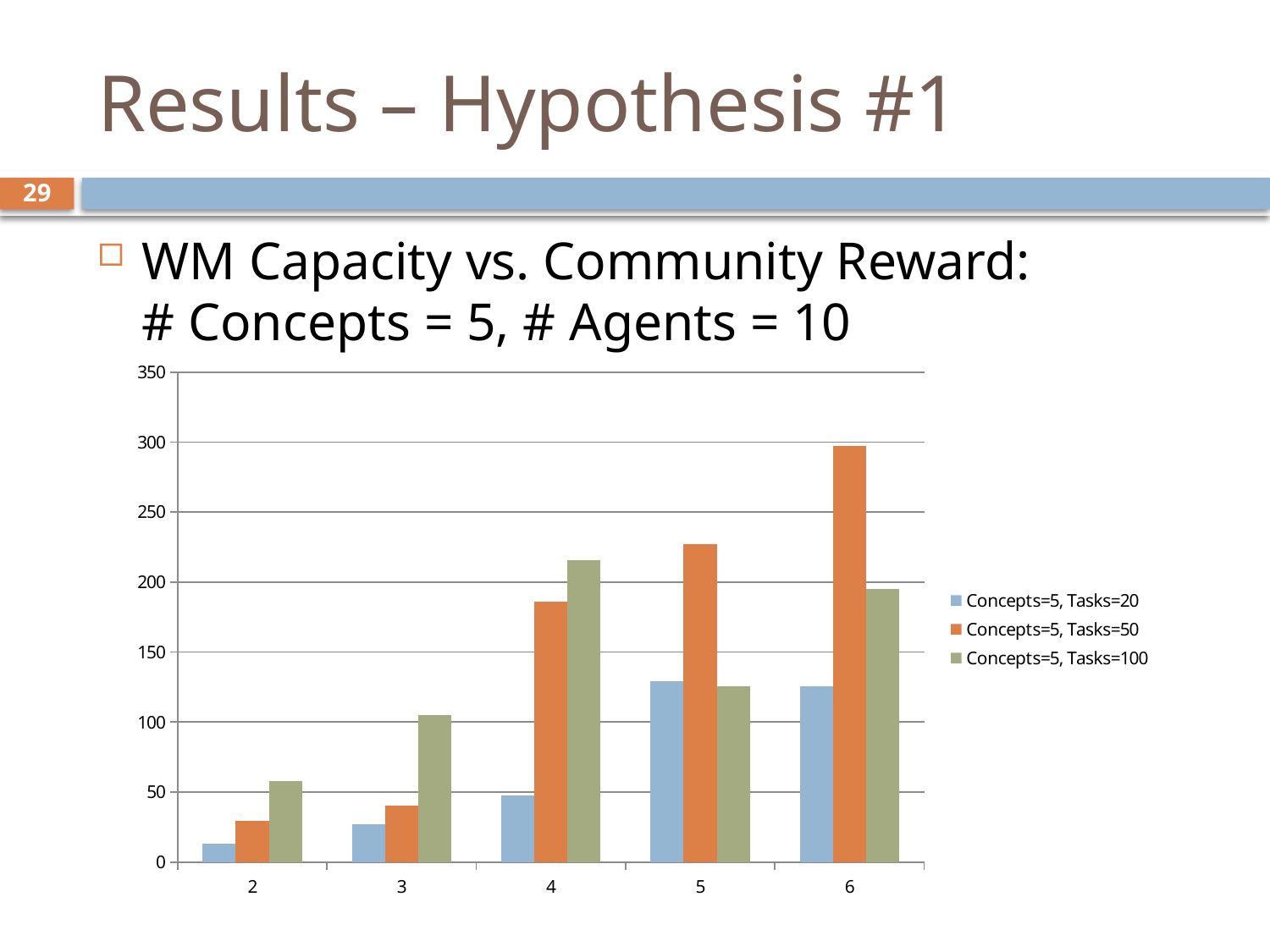
At x = 6, which series has the larger value: Concepts=5, Tasks=50 or Concepts=5, Tasks=100? Concepts=5, Tasks=50 How many categories are shown on the x axis of the chart? 5 What colour are the bars for the Concepts=5, Tasks=50 series? orange Is the value for Concepts=5, Tasks=100 at x = 3 greater or less than 150? less For the Concepts=5, Tasks=50 series, which x-axis category has the highest bar? 6 Is the value for Concepts=5, Tasks=50 at x = 6 greater or less than 250? greater What kind of chart is shown on the slide? bar chart Is the value for Concepts=5, Tasks=20 at x = 5 greater or less than 100? greater At x = 4, which series has the larger value: Concepts=5, Tasks=50 or Concepts=5, Tasks=100? Concepts=5, Tasks=100 For the Concepts=5, Tasks=20 series, which x-axis category has the lowest bar? 2 How many series does the chart's legend list? 3 Do the values for the Concepts=5, Tasks=50 series rise or fall as x increases from 2 to 6? rise